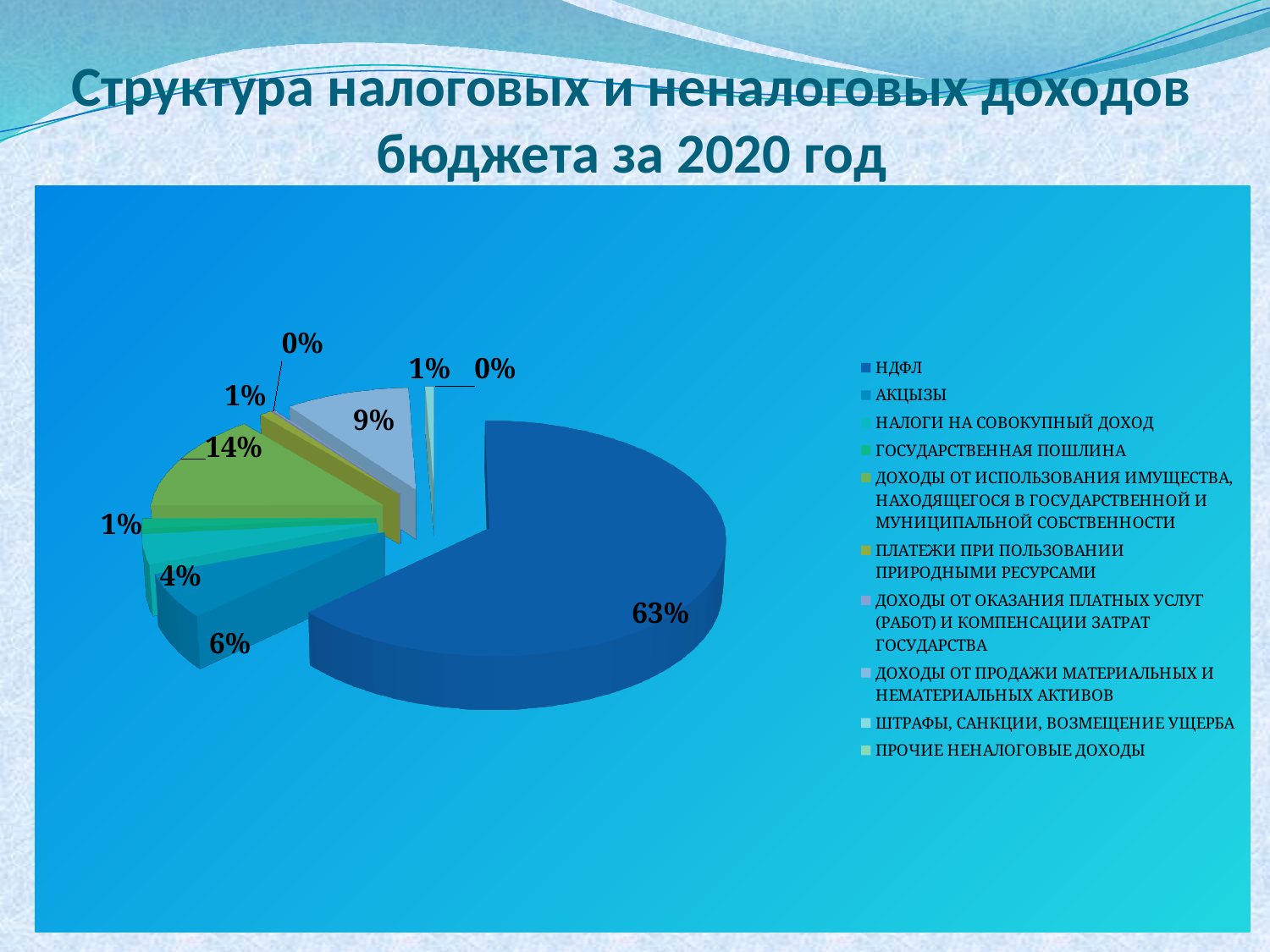
What kind of chart is shown on the slide? Pie chart What is the second-largest percentage label shown on the pie? 14% How many entries does the legend list? 10 What is the title of the slide? Структура налоговых и неналоговых доходов бюджета за 2020 год What share of the pie does НДФЛ have? 63% What is the difference between the 63% slice and the 14% slice? 49% How many slices are labelled 1%? 3 Which category has the largest share of the pie? НДФЛ How many slices are labelled 0%? 2 What is the largest percentage label shown on the pie? 63% Which is larger, the slice labelled 9% or the slice labelled 6%? The 9% slice What is the first entry listed in the legend? НДФЛ